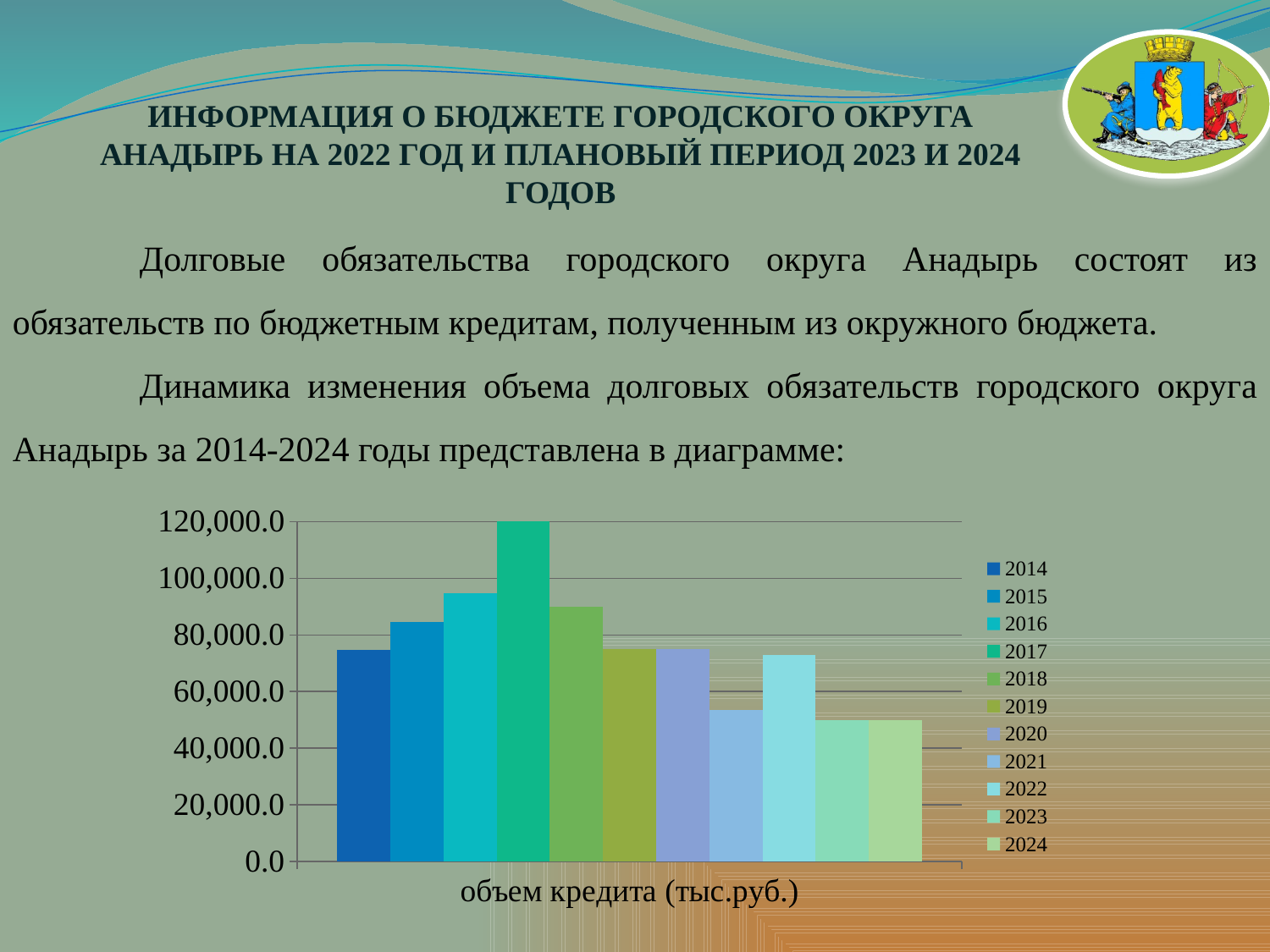
Which is larger, the value for 2015 or the value for 2016? 2016 Is the value for 2023 greater or less than 60,000.0? less Is the value for 2018 greater or less than 80,000.0? greater Is the value for 2021 greater or less than 60,000.0? less Which is larger, the value for 2021 or the value for 2022? 2022 How many series does the legend list? 11 What is the label shown on the horizontal axis of the chart? объем кредита (тыс.руб.) What kind of chart is shown on the slide? bar chart Which year has the highest value in the chart? 2017 What is the value for 2017 in the chart? 120,000.0